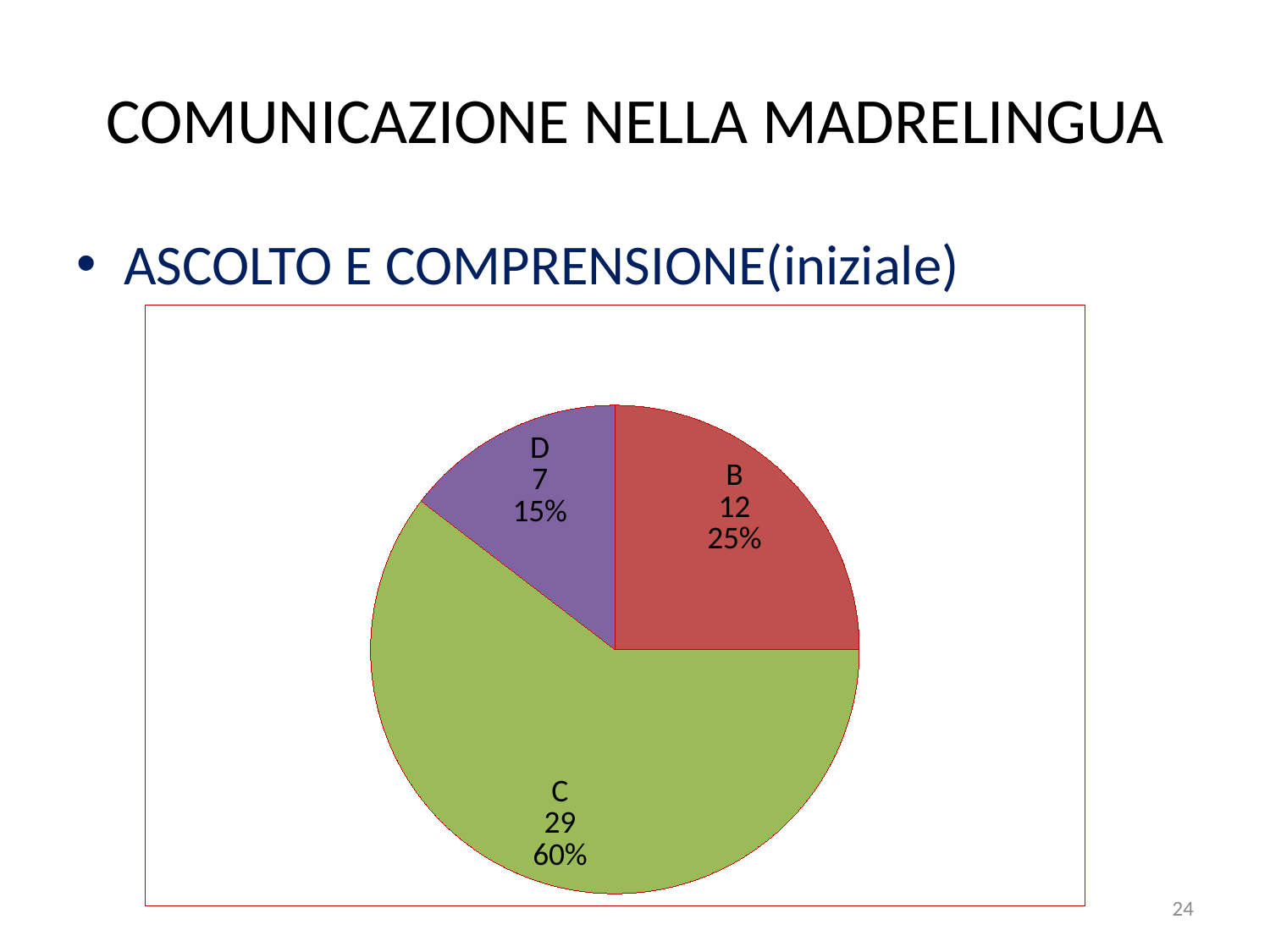
What kind of chart is shown on the slide? pie chart How many slices does the pie chart have? 3 Which slice is the largest? C What is the value for slice B? 12 What is the value for slice D? 7 Which is larger, the value for B or the value for D? B What percentage share of the pie does slice C have? 60% What percentage share of the pie does slice D have? 15% What colour is slice C? green What is the difference between the values for C and B? 17 What is the value for slice C? 29 Which slice is the smallest? D